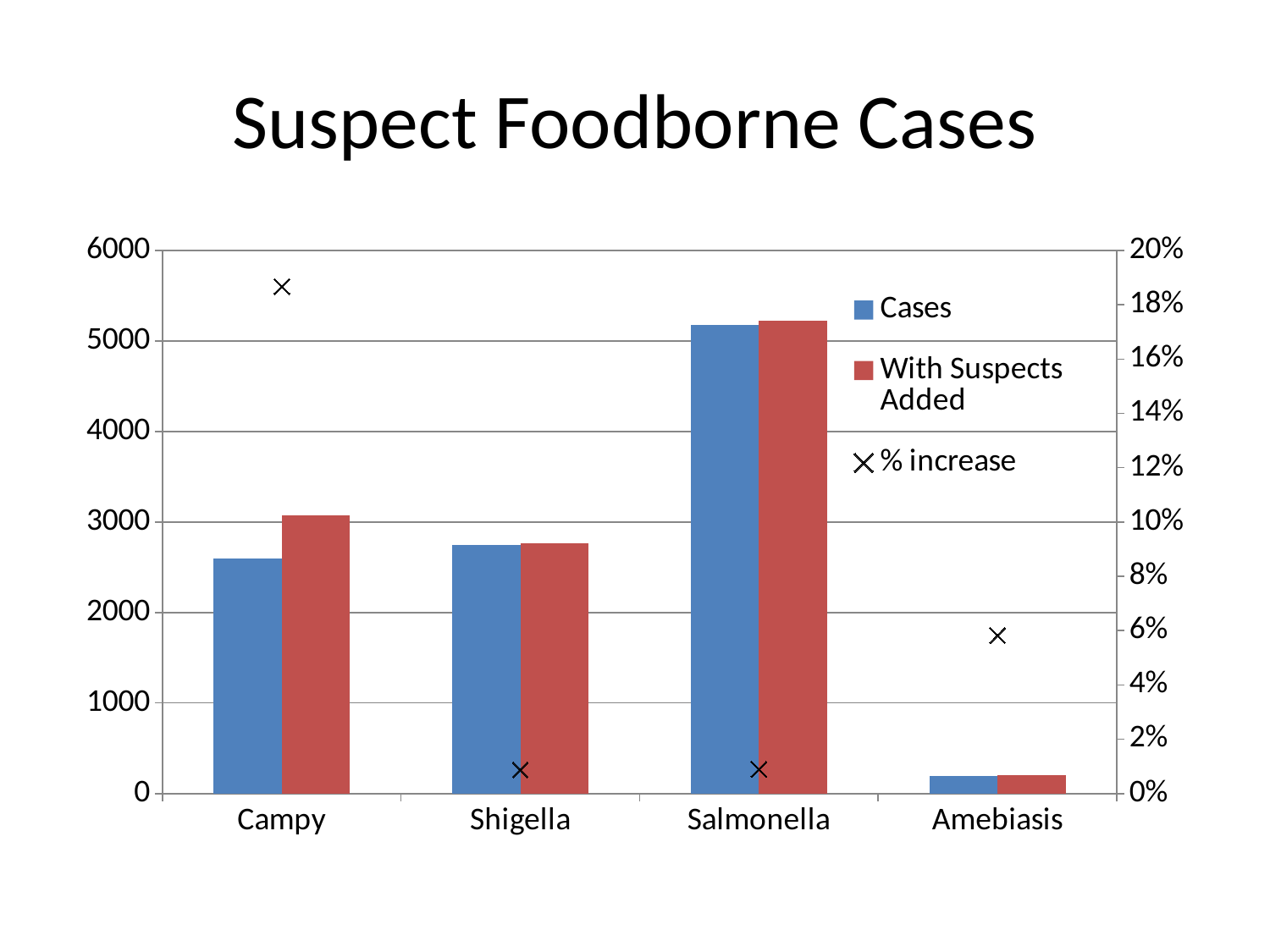
Which category has the lowest value for Cases? Amebiasis Is the value for With Suspects Added for Campy greater or less than 3000? greater Is the value for Cases for Campy greater or less than 3000? less What kind of chart is used to plot the Cases and With Suspects Added series? bar chart How many series does the legend list? 3 Which category has the highest value for Cases? Salmonella Which category has the highest % increase? Campy Is the % increase for Amebiasis greater or less than 4%? greater Which is larger, the With Suspects Added value for Campy or for Shigella? Campy How many categories are shown on the x axis? 4